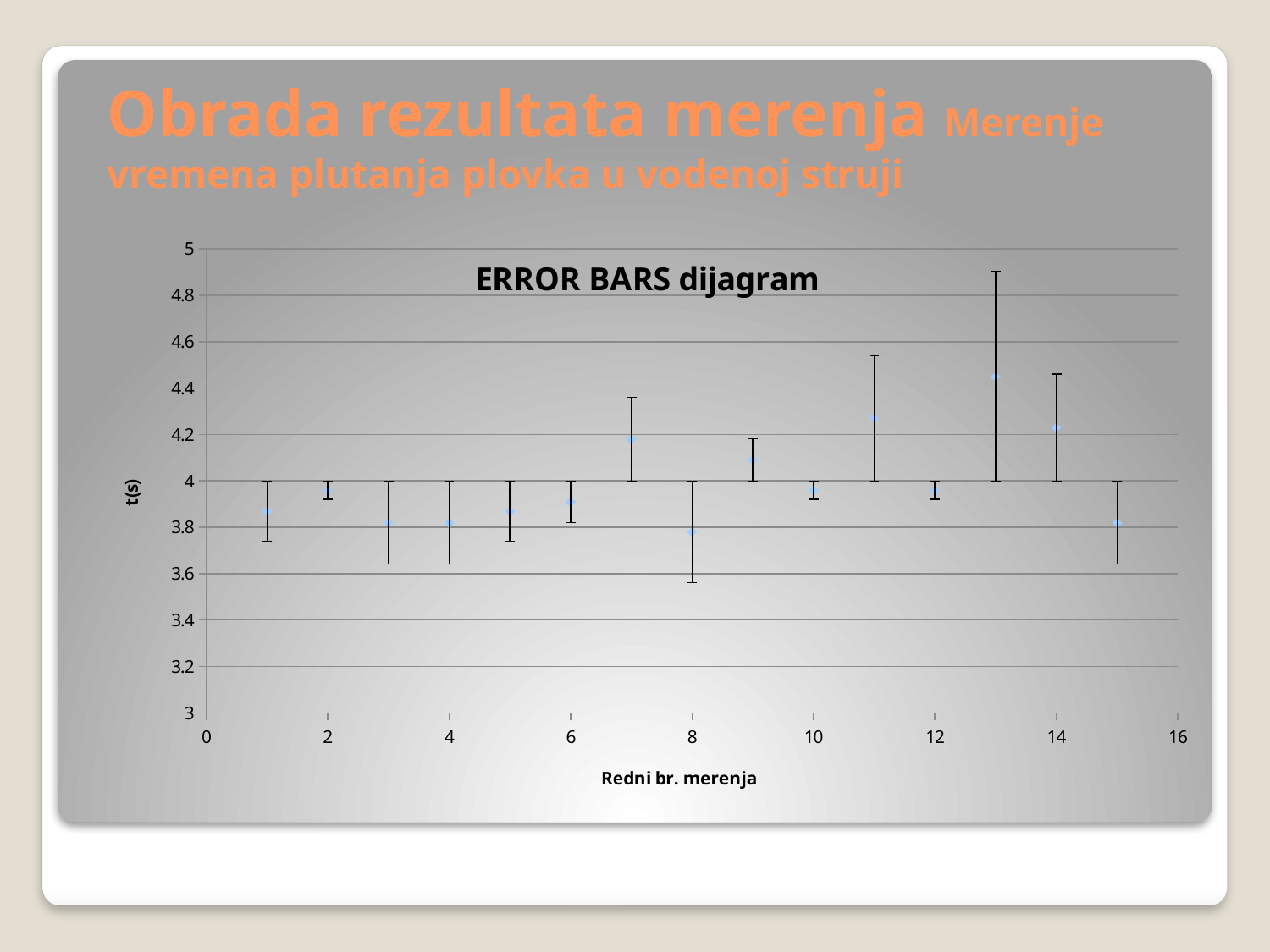
Is the value for measurement 7 greater or less than 4? greater Which measurement number (Redni br. merenja) has the highest value of t(s)? 13 Is the value for measurement 11 greater or less than 4.2? greater Is the value for measurement 1 greater or less than 4? less Which has the larger value of t(s): measurement 7 or measurement 3? measurement 7 Which has the larger value of t(s): measurement 13 or measurement 8? measurement 13 How many measurement points are plotted on the chart? 15 What kind of chart is shown on the slide? scatter chart with error bars What is the title of the chart? ERROR BARS dijagram What is the label of the y axis? t(s)